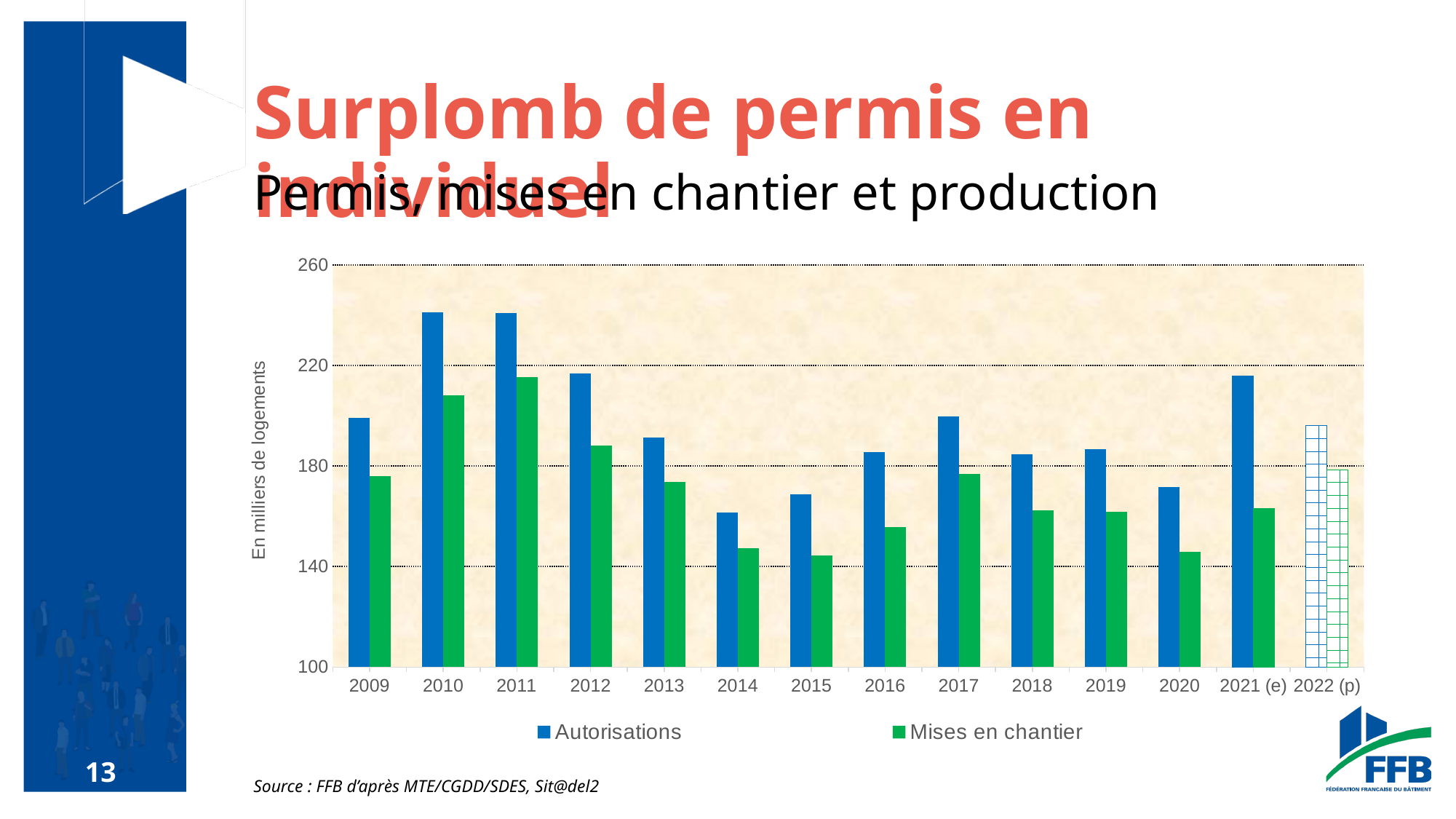
Is the value for Mises en chantier in 2010 greater or less than 220? less How many years (categories) are shown on the x axis? 14 Which is larger: Autorisations in 2012 or Autorisations in 2013? 2012 What kind of chart is shown on the slide? bar chart Is the value for Autorisations in 2017 greater or less than 180? greater In which year is the Autorisations value lowest? 2014 How many series does the legend list? 2 Is the value for Autorisations in 2014 greater or less than 180? less In which year is the Mises en chantier value highest? 2011 Do the Autorisations values rise or fall from 2011 to 2014? fall